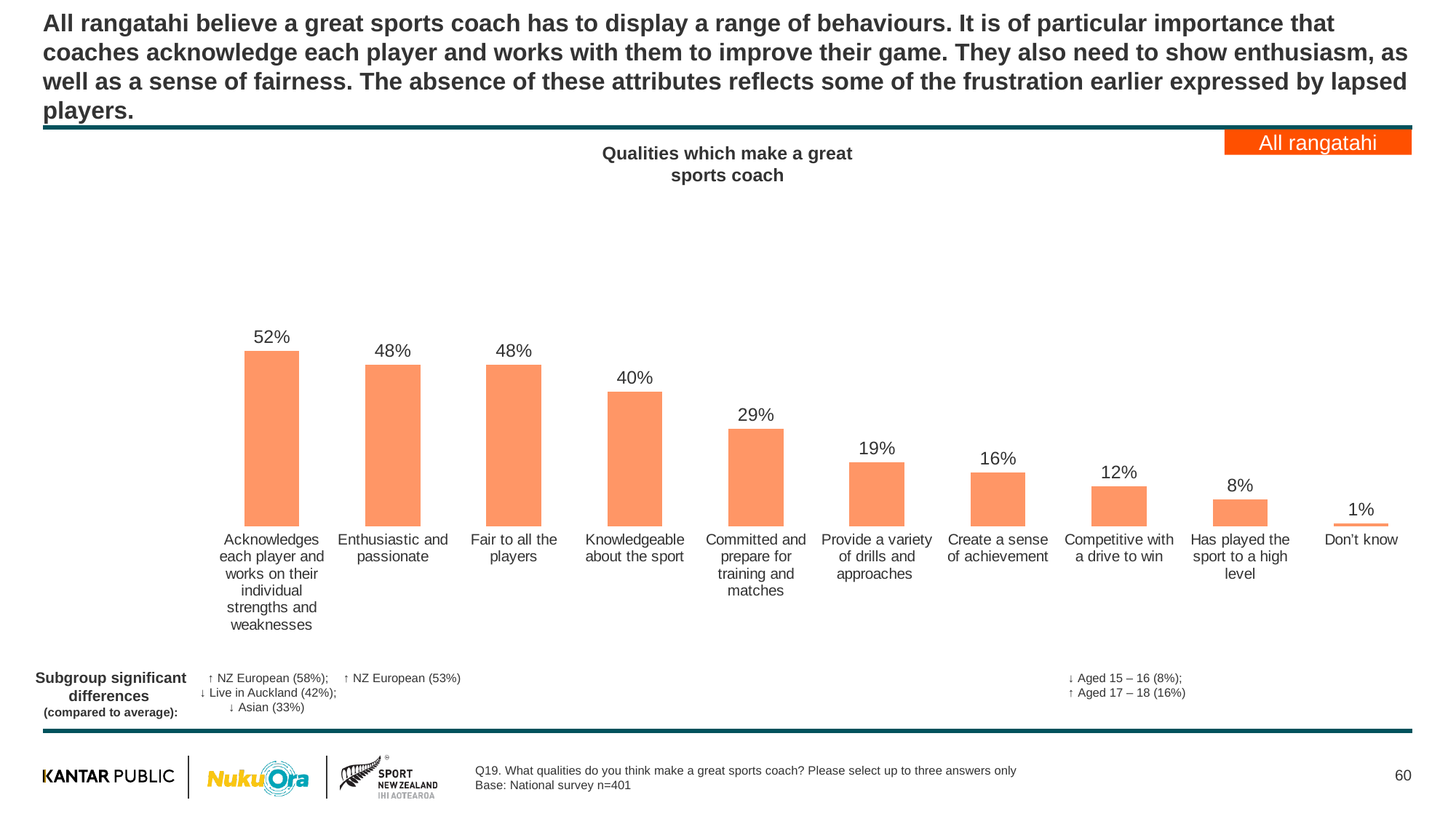
What percentage selected 'Competitive with a drive to win'? 12% What percentage of rangatahi said a great sports coach is knowledgeable about the sport? 40% Which is larger: the value for 'Has played the sport to a high level' or 'Competitive with a drive to win'? Competitive with a drive to win How many categories are shown in the chart? 10 Do the values rise or fall moving from left to right across the chart? Fall What is the value for 'Committed and prepare for training and matches'? 29% What is the title of the chart? Qualities which make a great sports coach What is the difference between the values for 'Enthusiastic and passionate' and 'Knowledgeable about the sport'? 8% Which quality has the highest percentage in the chart? Acknowledges each player and works on their individual strengths and weaknesses What is the difference between 'Provide a variety of drills and approaches' and 'Create a sense of achievement'? 3% Which category has the lowest value in the chart? Don't know What type of chart is shown on the slide? Bar chart